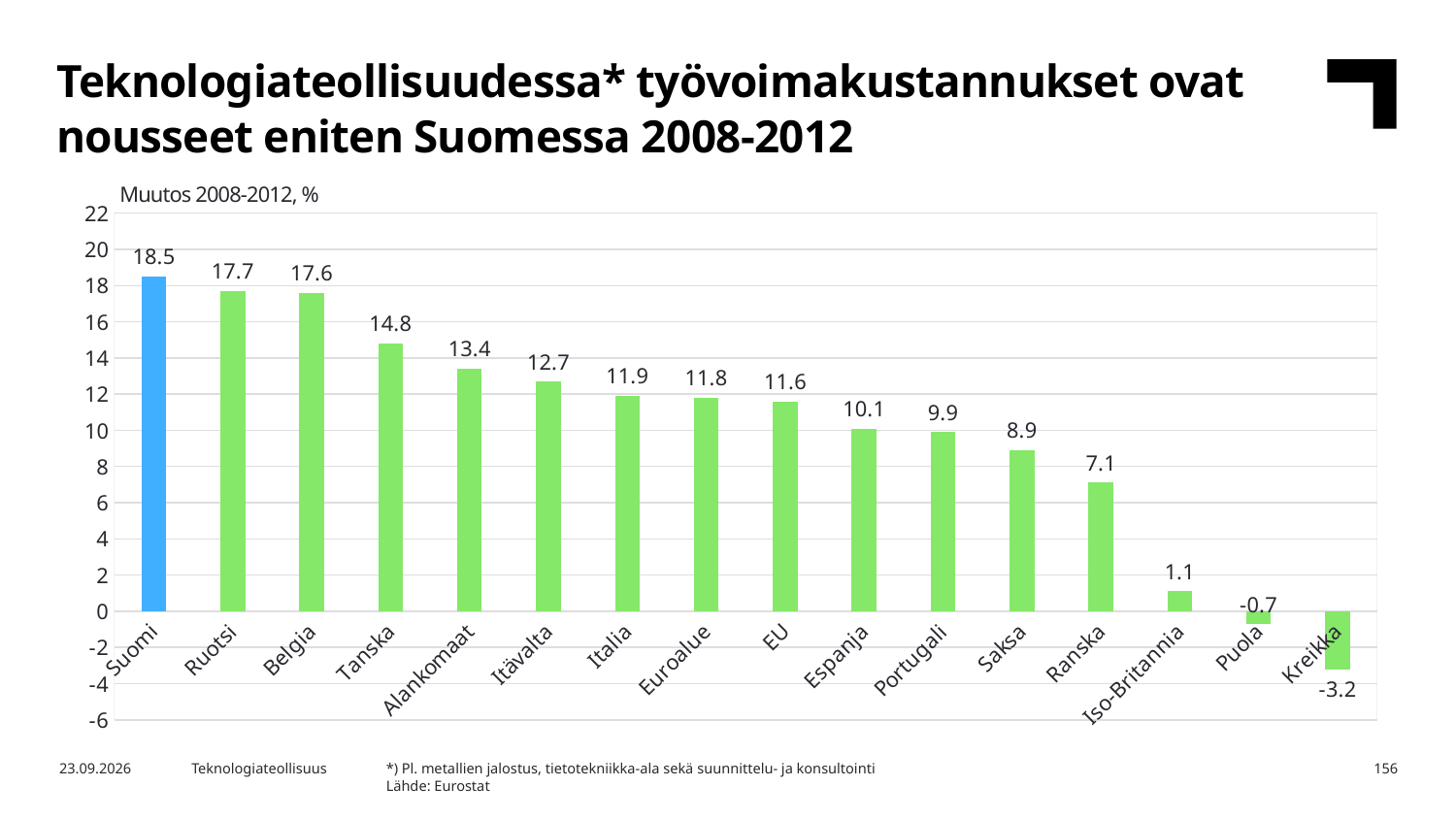
What is the difference between the values for Suomi and Ruotsi? 0.8 What kind of chart is shown on the slide? Bar chart What is the value for Alankomaat? 13.4 Which country has the lowest value? Kreikka What is the value for Kreikka? -3.2 How many categories are shown on the x axis? 16 What is the value for Iso-Britannia? 1.1 What is the label shown above the chart's y axis? Muutos 2008-2012, % What is the difference between the values for Tanska and Saksa? 5.9 Which country has the highest value? Suomi What is the value for Suomi? 18.5 Which is larger, the value for Espanja or the value for Ranska? Espanja